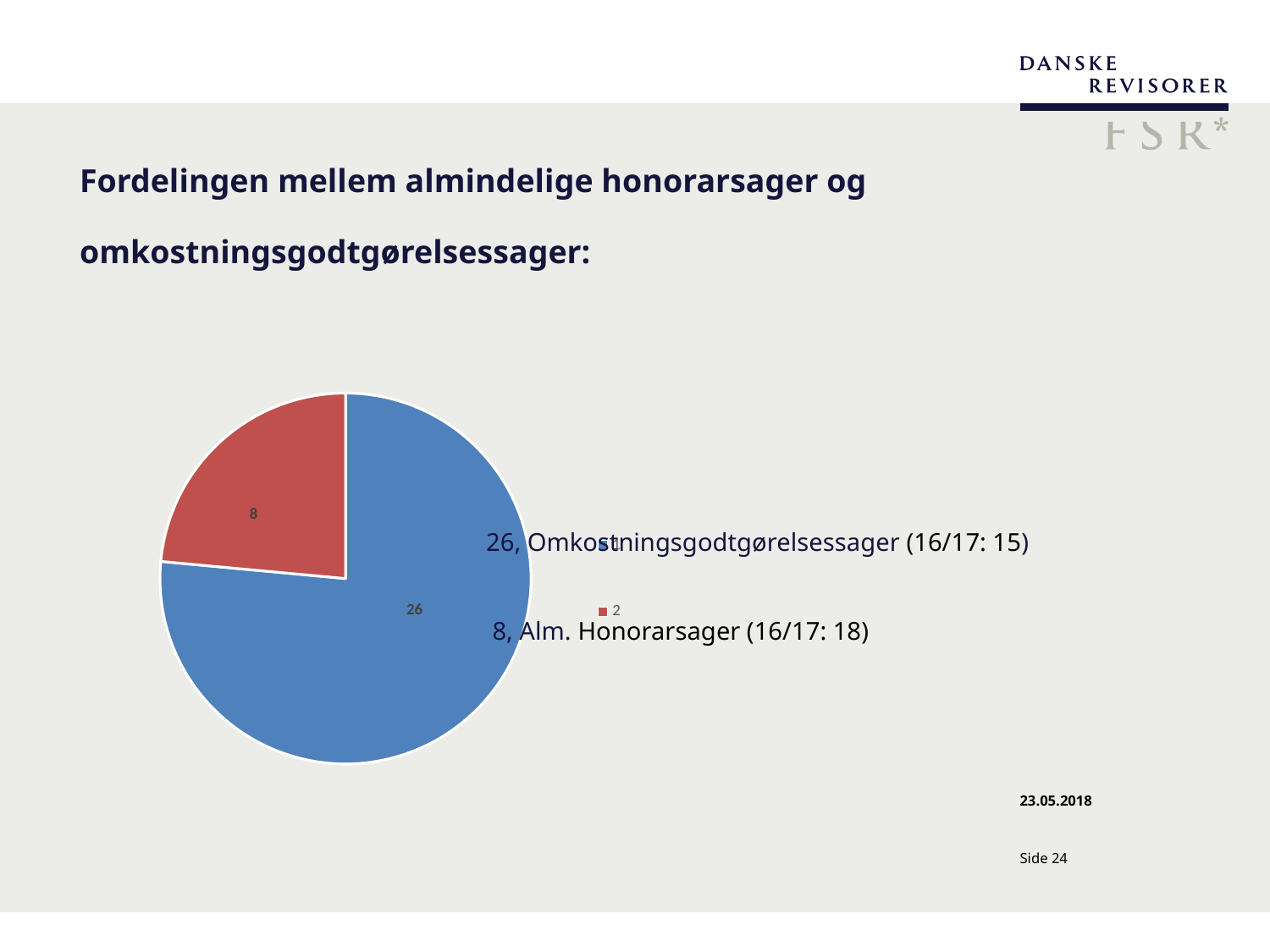
What is the value of the red slice labelled Alm. Honorarsager? 8 What is the total of the two slices in the pie chart? 34 What is the value of the blue slice labelled Omkostningsgodtgørelsessager? 26 According to the text next to the chart, what was the 16/17 value for Omkostningsgodtgørelsessager? 15 Which category has the largest slice in the pie chart? Omkostningsgodtgørelsessager Which is larger, the Omkostningsgodtgørelsessager slice or the Alm. Honorarsager slice? Omkostningsgodtgørelsessager What is the difference between the Omkostningsgodtgørelsessager slice and the Alm. Honorarsager slice? 18 What colour is the slice representing Alm. Honorarsager? red How many slices does the pie chart have? 2 According to the text next to the chart, what was the 16/17 value for Alm. Honorarsager? 18 Which category has the smallest slice in the pie chart? Alm. Honorarsager What kind of chart is shown on the slide? pie chart